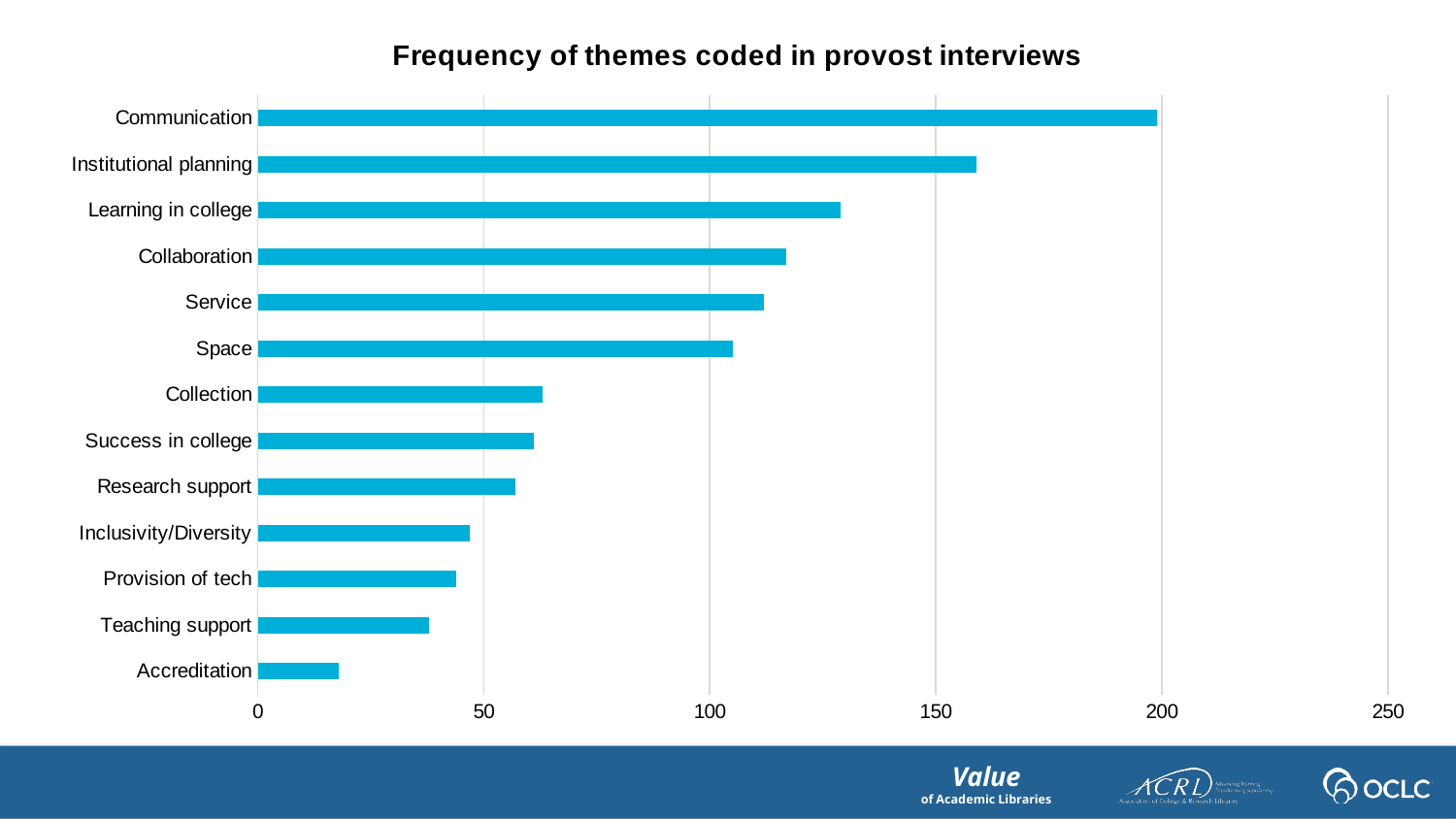
What kind of chart is shown on the slide? bar chart Which has a higher frequency, Institutional planning or Space? Institutional planning How many themes are plotted in the chart? 13 Is the value for Teaching support greater or less than 50? less Is the value for Accreditation greater or less than 50? less Is the value for Learning in college greater or less than 100? greater Which theme has the lowest frequency? Accreditation Which has a higher frequency, Collection or Provision of tech? Collection Which theme has the highest frequency? Communication What is the title of the chart? Frequency of themes coded in provost interviews